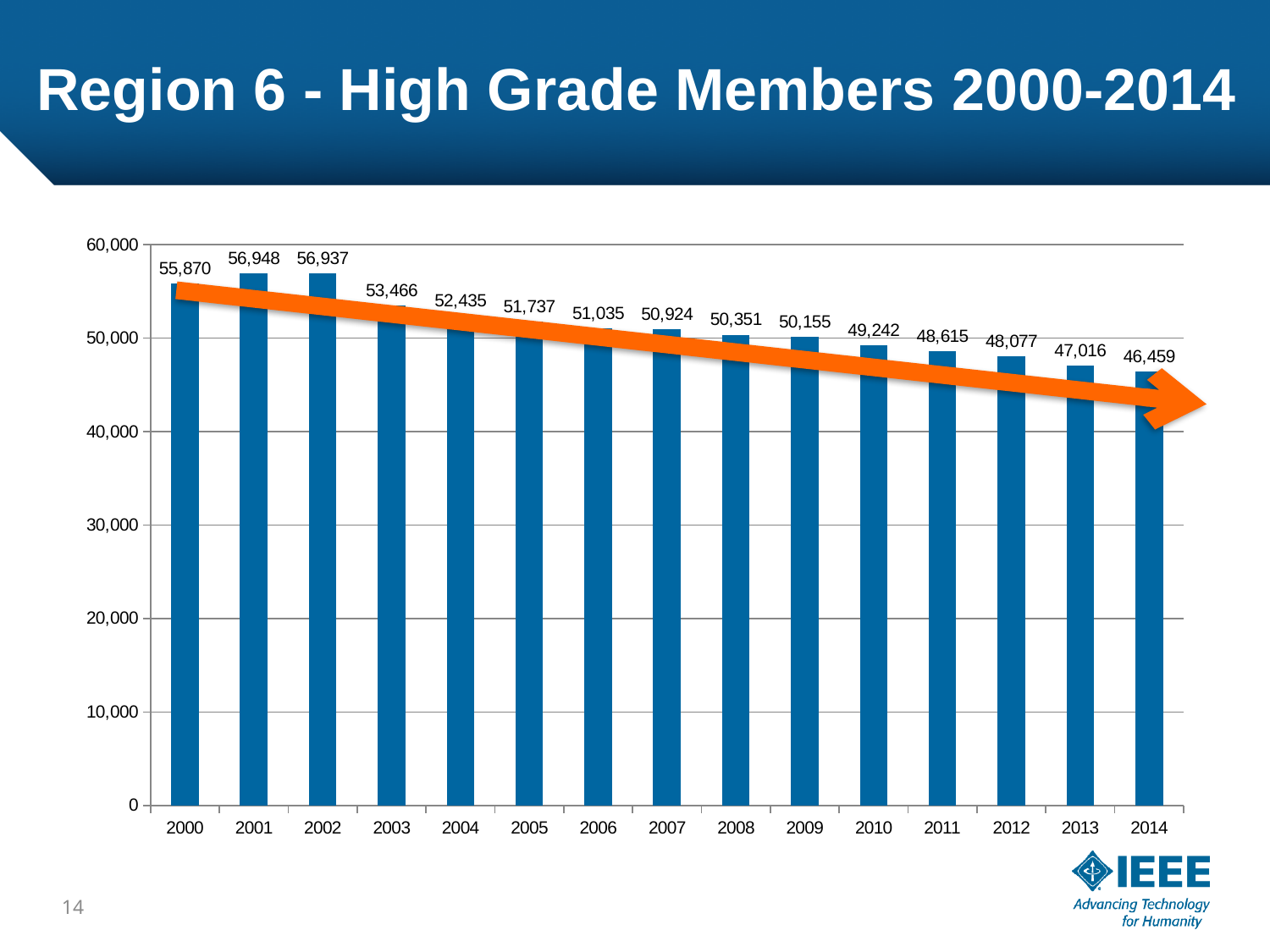
What kind of chart is shown on the slide? bar chart Is the value for 2010 greater or less than 50,000? less What is the value for 2014? 46,459 How many years are shown on the x axis? 15 Which is larger, the value for 2005 or the value for 2009? 2005 What is the value for 2000? 55,870 What is the difference between the values for 2000 and 2014? 9,411 Which year has the highest value? 2001 What is the difference between the values for 2003 and 2004? 1,031 What is the value for 2007? 50,924 Which year has the lowest value? 2014 Do the values generally rise or fall from 2002 to 2014? fall